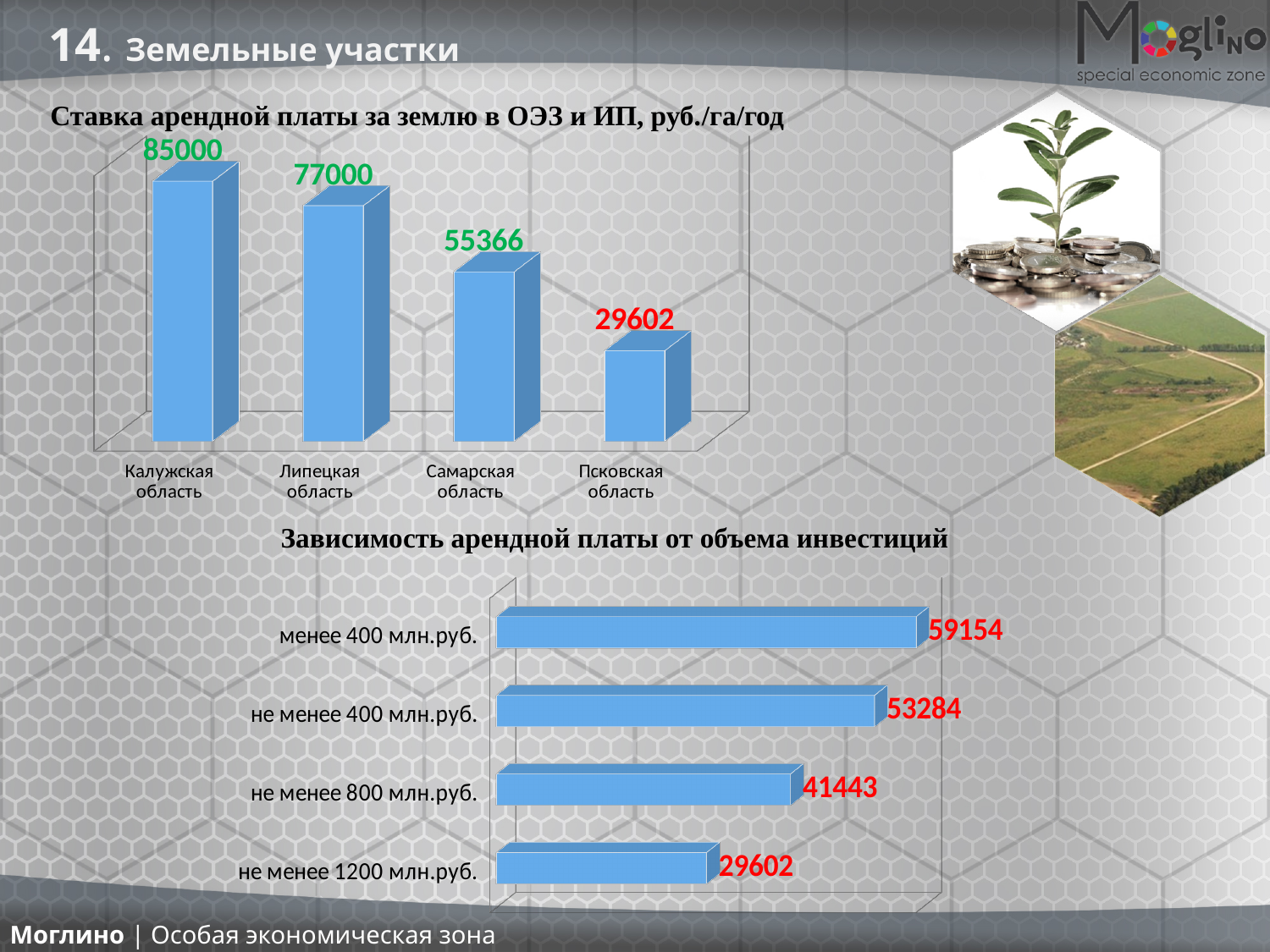
In the top chart (Ставка арендной платы за землю в ОЭЗ и ИП), what is the value for Калужская область? 85000 In the top chart, which region has the highest rental rate? Калужская область In the top chart, how many regions are shown? 4 In the top chart, which region has the lowest rental rate? Псковская область In the bottom chart (Зависимость арендной платы от объема инвестиций), what is the value for 'не менее 800 млн.руб.'? 41443 In the bottom chart, what is the difference between the values for 'не менее 400 млн.руб.' and 'не менее 1200 млн.руб.'? 23682 In the top chart, what is the difference between the values for Калужская область and Липецкая область? 8000 What type of chart is the bottom chart? bar chart In the top chart, what is the value for Самарская область? 55366 In the bottom chart, what is the value for 'менее 400 млн.руб.'? 59154 In the bottom chart, which investment category has the lowest rental rate? не менее 1200 млн.руб. In the top chart, do the values rise or fall from left to right? fall